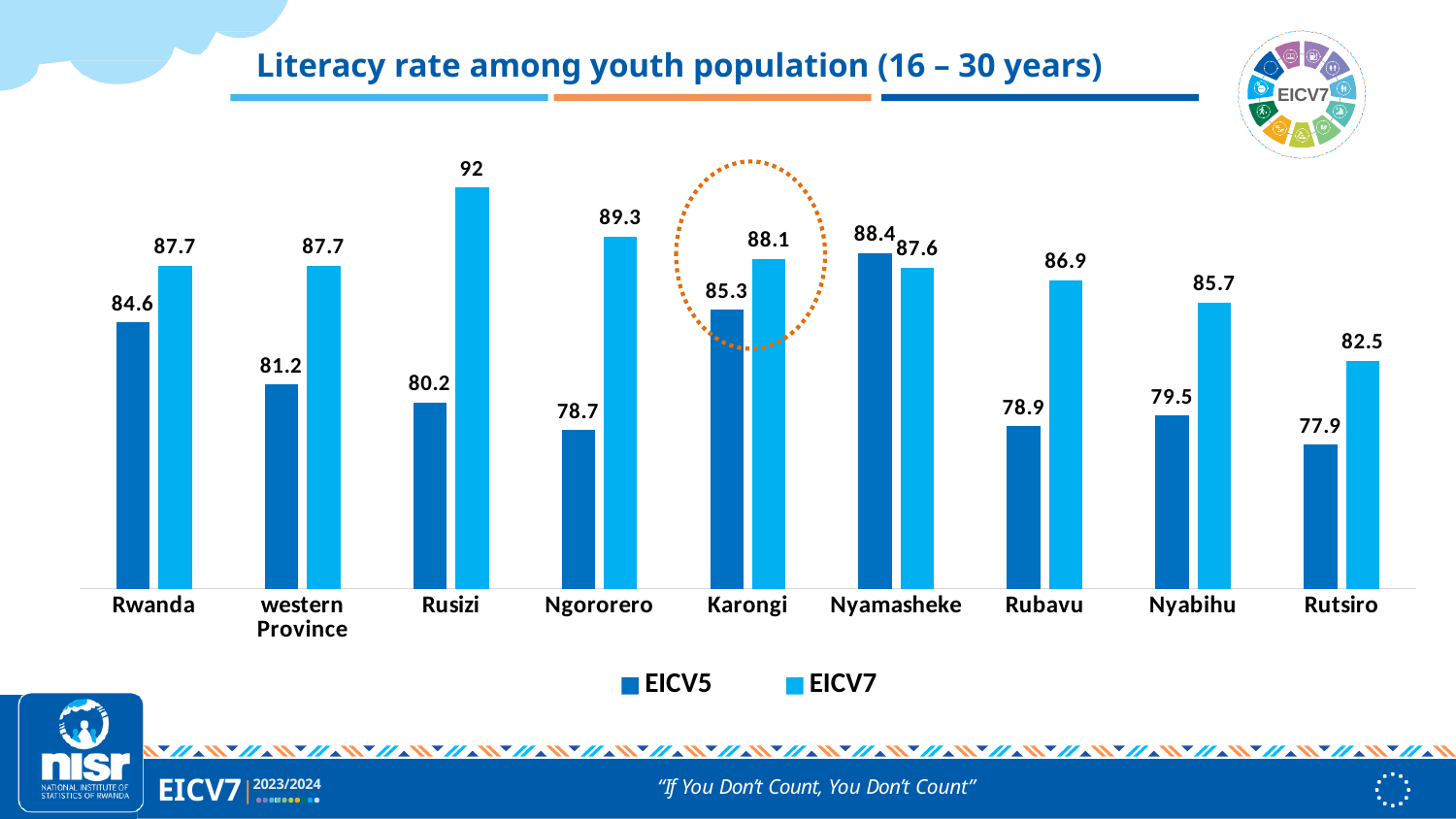
Which category has the lowest EICV5 value? Rutsiro Which category is highlighted with a dotted orange circle? Karongi What is the EICV5 literacy rate for Karongi? 85.3 How many series does the legend list? 2 What is the difference between the EICV7 and EICV5 values for Rusizi? 11.8 What kind of chart is shown on the slide? Bar chart How many categories are shown on the x axis? 9 Which category has the highest EICV7 value? Rusizi Which category has the highest EICV5 value? Nyamasheke What is the EICV7 literacy rate for Rusizi? 92 What is the difference between the EICV7 and EICV5 values for Ngororero? 10.6 For Nyamasheke, which is larger, the EICV5 value or the EICV7 value? EICV5